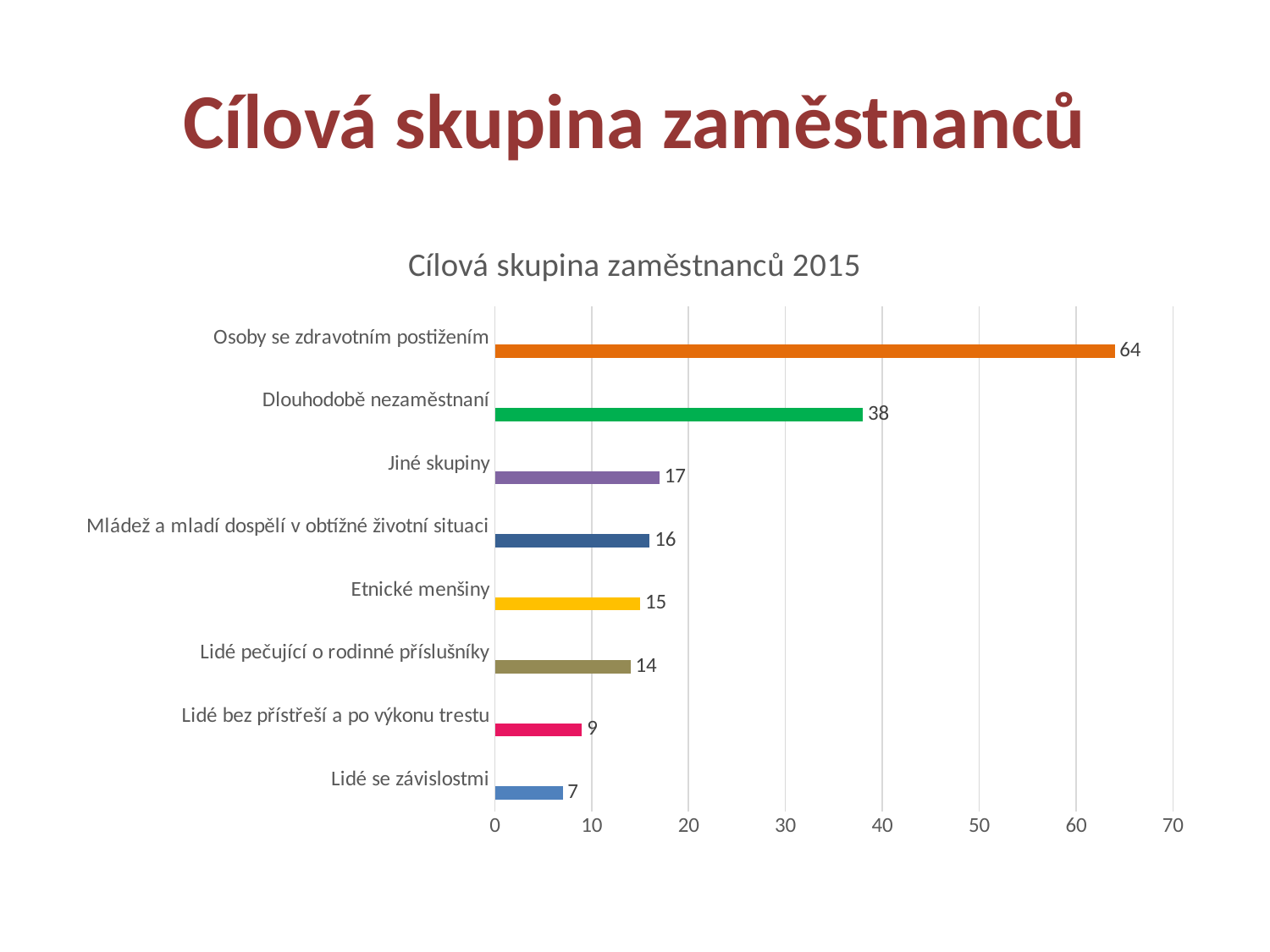
What is the value for Osoby se zdravotním postižením? 64 What is the value for Dlouhodobě nezaměstnaní? 38 What kind of chart is shown on the slide? bar chart Which category has the highest value? Osoby se zdravotním postižením Which category has the lowest value? Lidé se závislostmi How many categories are shown in the chart? 8 What is the value for Etnické menšiny? 15 What is the value for Lidé se závislostmi? 7 Which is larger, the value for Jiné skupiny or the value for Lidé pečující o rodinné příslušníky? Jiné skupiny What is the title of the chart? Cílová skupina zaměstnanců 2015 Is the value for Lidé bez přístřeší a po výkonu trestu greater or less than 10? less What is the difference between the values for Osoby se zdravotním postižením and Dlouhodobě nezaměstnaní? 26